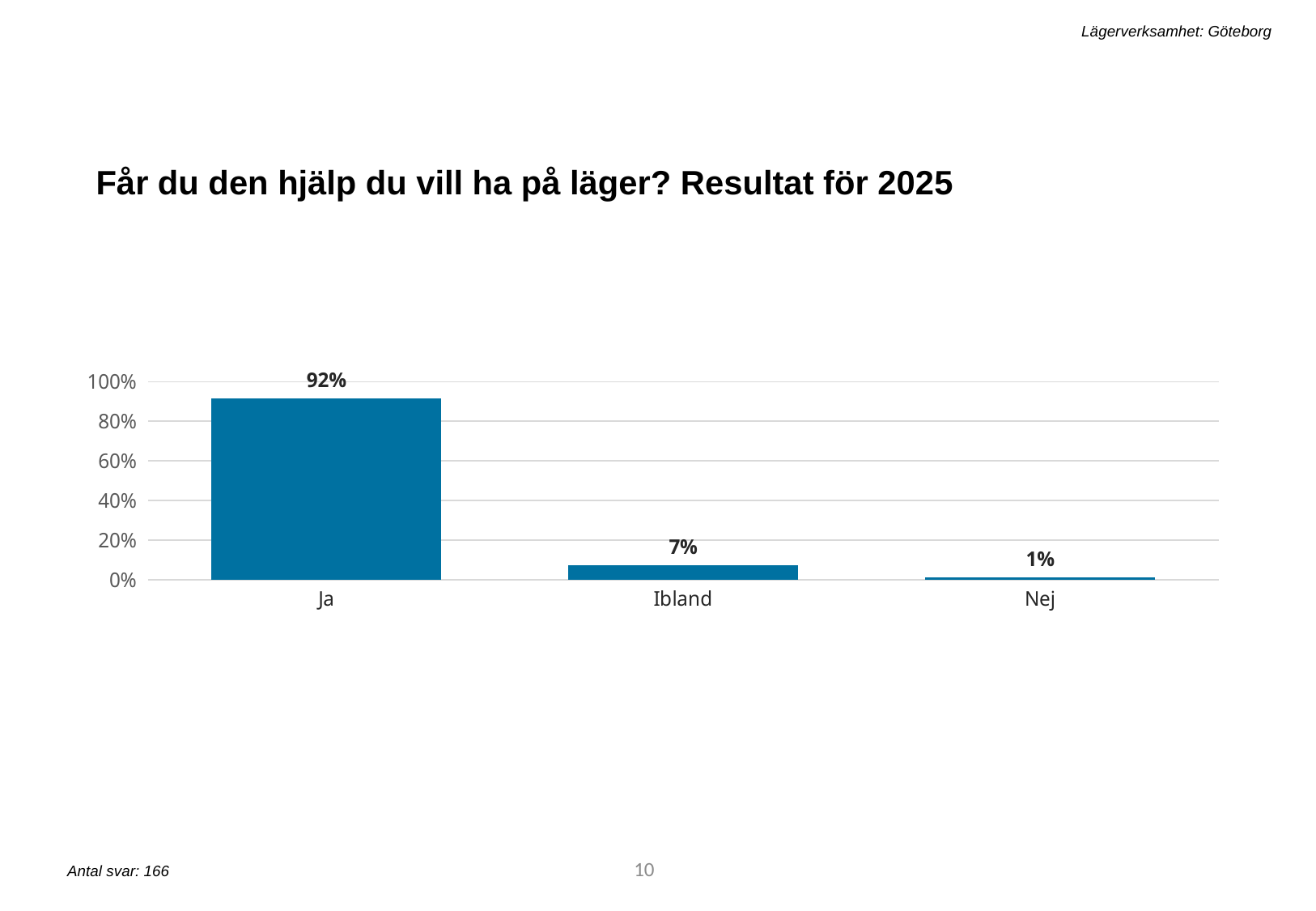
Which category has the lowest value? Nej What is the difference between the values for Ja and Ibland? 85% What is the difference between the values for Ibland and Nej? 6% What is the value for Ja? 92% What is the value for Nej? 1% What is the value for Ibland? 7% What kind of chart is shown on the slide? bar chart Which category has the highest value? Ja Which is larger, the value for Ibland or the value for Nej? Ibland What is the title of the chart? Får du den hjälp du vill ha på läger? Resultat för 2025 How many categories are shown on the x axis? 3 Is the value for Ja greater or less than 80%? greater